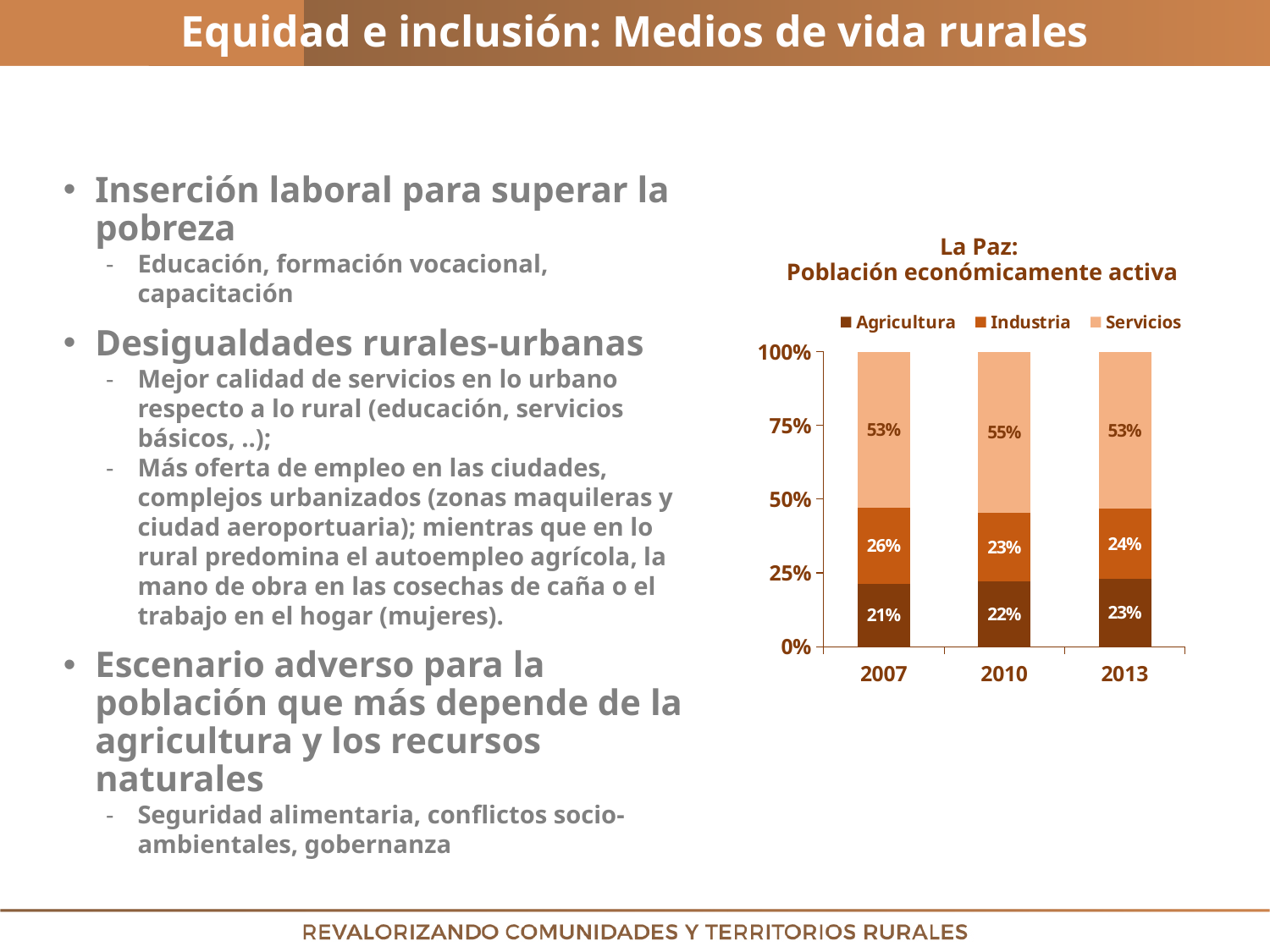
What is the difference between the Industria value in 2007 and in 2010? 3% In which year is the Servicios share highest? 2010 What is the title of the chart? La Paz: Población económicamente activa What is the value for Industria in 2013? 24% What is the value for Servicios in 2010? 55% In which year is the Agricultura share lowest? 2007 Does the Agricultura share rise or fall from 2007 to 2013? Rise What kind of chart is shown? Stacked bar chart How many series does the legend list? 3 How many years are shown on the x axis? 3 Which is larger in 2013, Agricultura or Industria? Industria What is the value for Agricultura in 2007? 21%